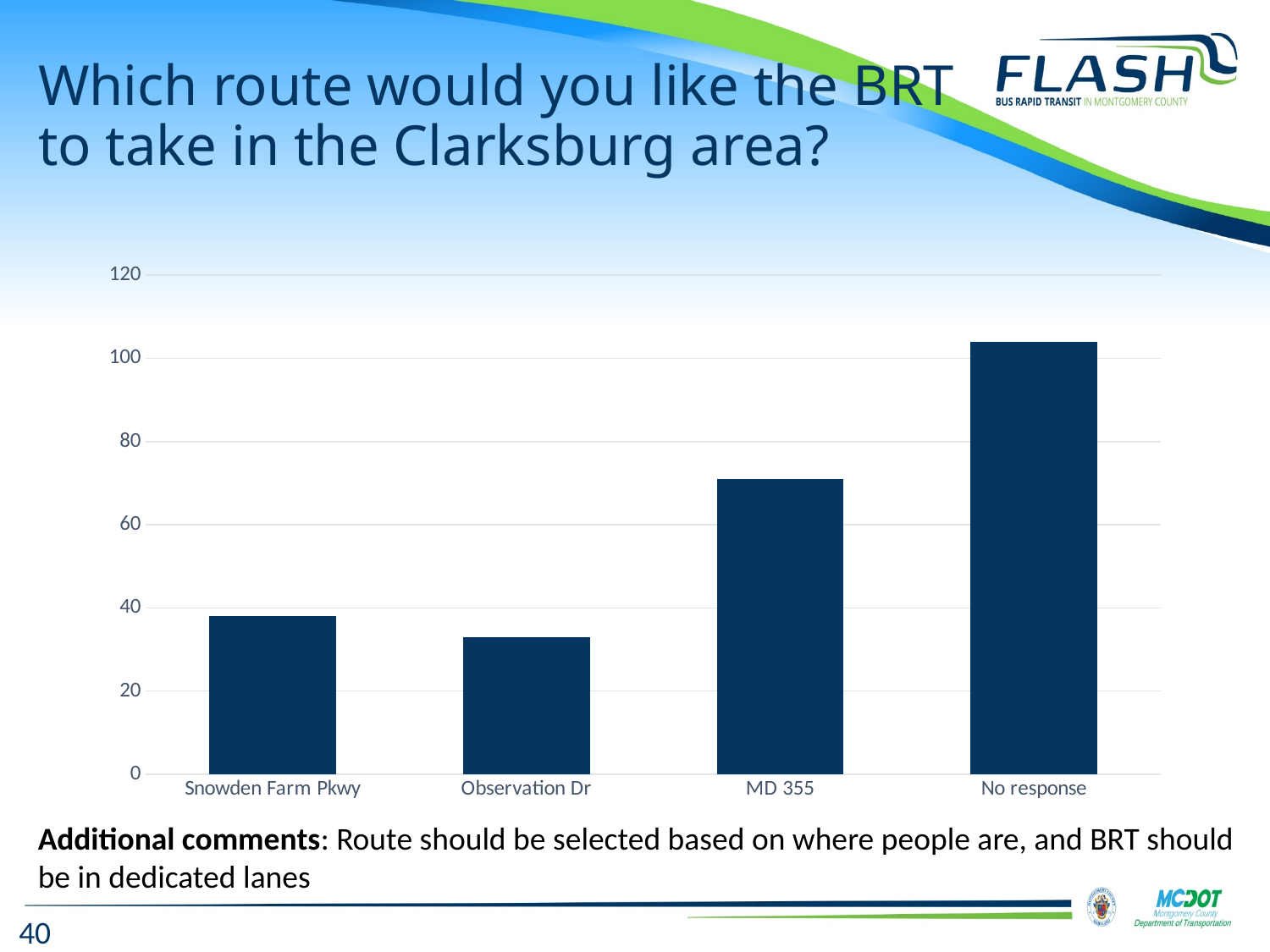
Is the value for Observation Dr greater or less than 40? less What question does the slide title say the chart is answering? Which route would you like the BRT to take in the Clarksburg area? Is the value for MD 355 greater or less than 60? greater Which category has the highest bar in the chart? No response Which category has the lowest bar in the chart? Observation Dr Is the value for Snowden Farm Pkwy greater or less than 20? greater Which is larger, the value for No response or the value for MD 355? No response Which is larger, the value for MD 355 or the value for Snowden Farm Pkwy? MD 355 What kind of chart is shown on the slide? bar chart How many route options (categories) are shown on the x axis of the chart? 4